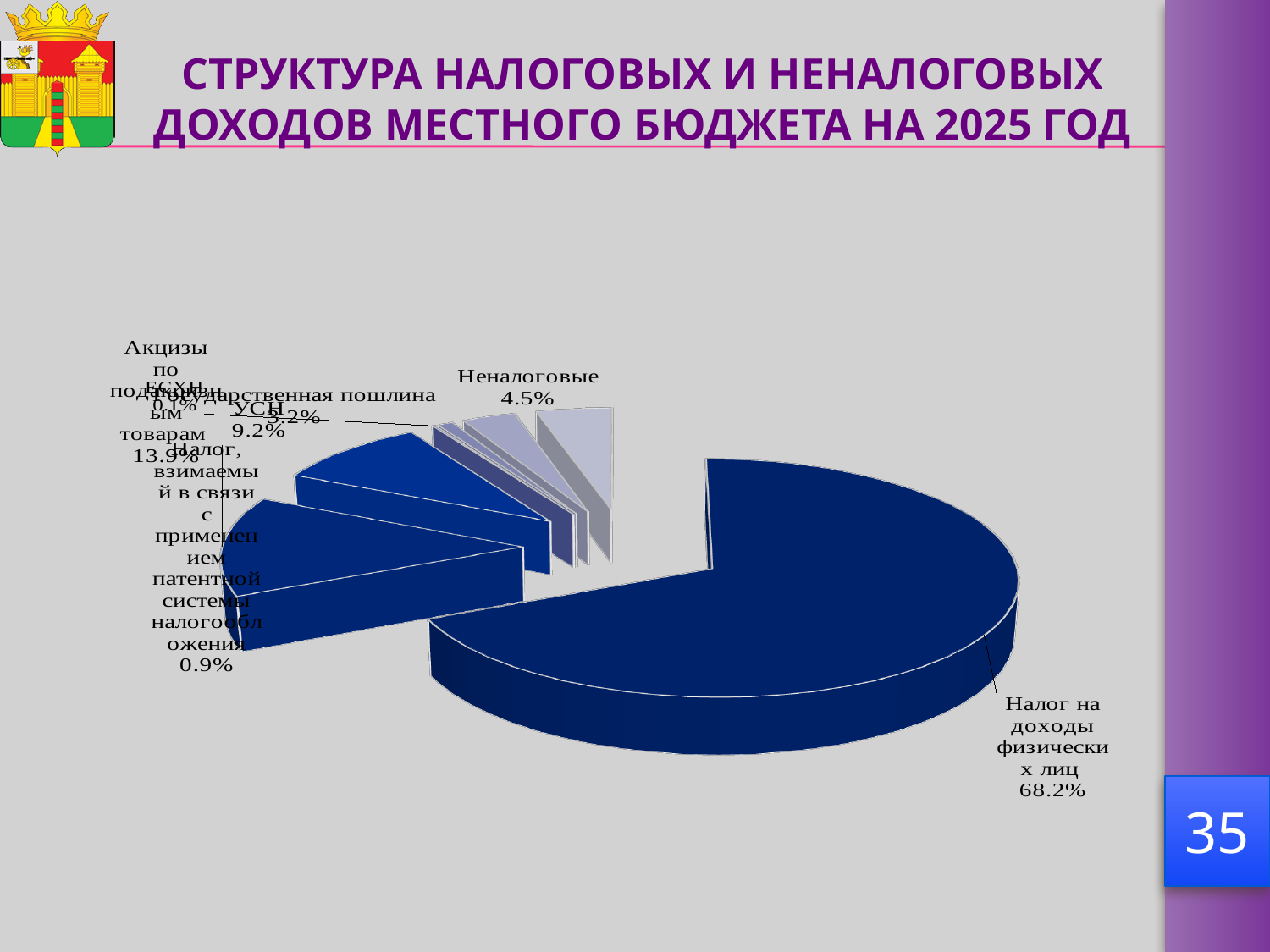
Which is larger: the share for "Акцизы по подакцизным товарам" or the share for "УСН"? Акцизы по подакцизным товарам What is the title of the slide containing the chart? СТРУКТУРА НАЛОГОВЫХ И НЕНАЛОГОВЫХ ДОХОДОВ МЕСТНОГО БЮДЖЕТА НА 2025 ГОД What share is shown for "Налог, взимаемый в связи с применением патентной системы налогообложения"? 0.9% Which is larger: the share for "Неналоговые" or the share for the patent system tax ("Налог, взимаемый в связи с применением патентной системы налогообложения")? Неналоговые What share is shown for "Неналоговые"? 4.5% By how many percentage points does "УСН" exceed "Неналоговые"? 4.7% By how many percentage points does "Налог на доходы физических лиц" exceed "Акцизы по подакцизным товарам"? 54.3% What share is shown for "УСН"? 9.2% Which category has the largest slice of the pie? Налог на доходы физических лиц What share of the pie is labelled for "Налог на доходы физических лиц"? 68.2% What kind of chart is shown on the slide? Pie chart What share is shown for "Акцизы по подакцизным товарам"? 13.9%